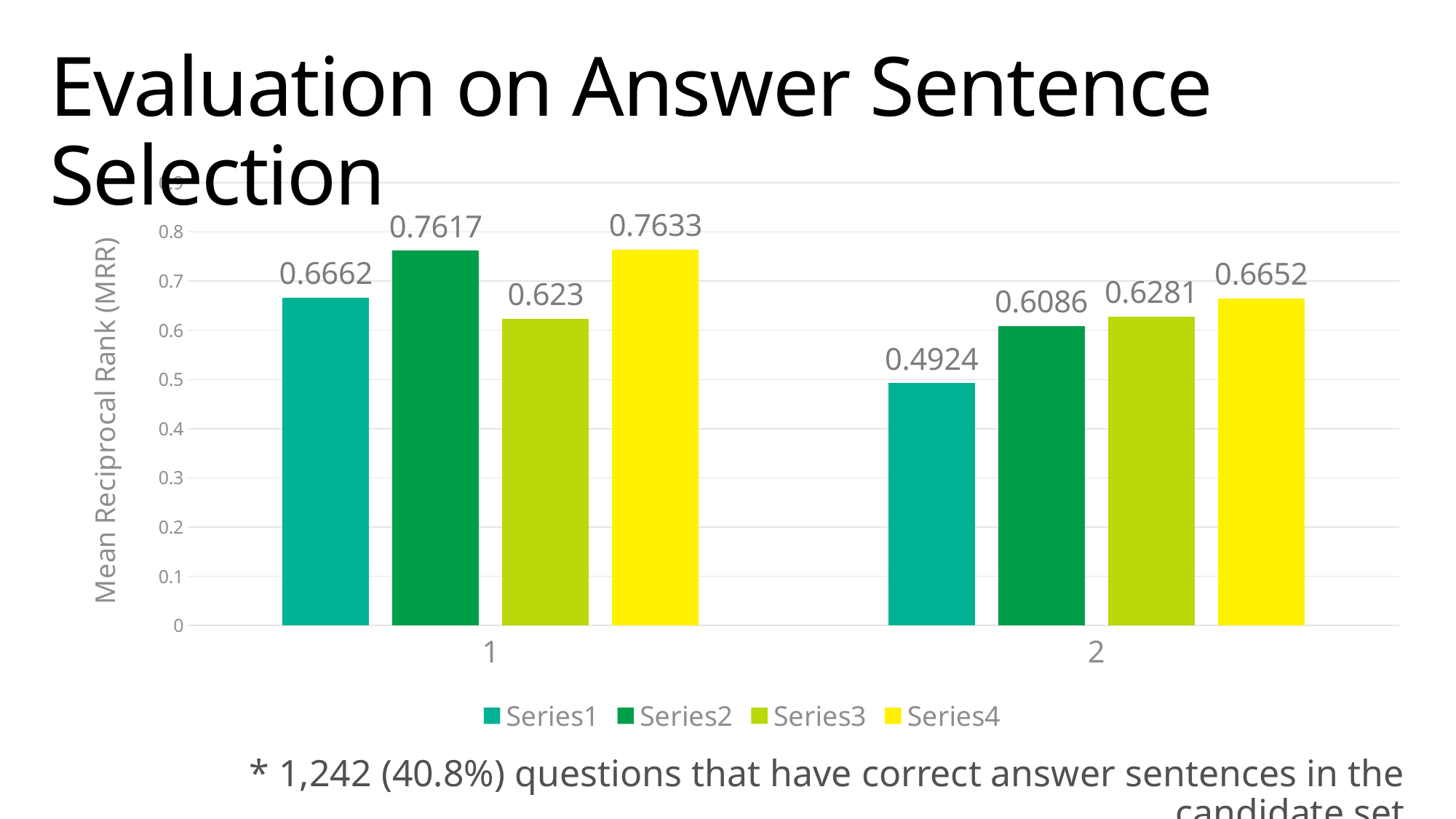
Which is larger: Series2 in category 2 or Series3 in category 2? Series3 in category 2 Which series has the lowest value in category 1? Series3 What is the value for Series4 in category 2? 0.6652 What is the label of the vertical axis? Mean Reciprocal Rank (MRR) What is the value for Series3 in category 1? 0.623 Is the value for Series1 in category 2 greater or less than 0.5? less How many series does the legend list? 4 Which series has the highest value in category 2? Series4 What kind of chart is shown on the slide? Bar chart What is the difference between the Series1 values for category 1 and category 2? 0.1738 Which series has the lowest value in category 2? Series1 What is the value for Series1 in category 1? 0.6662